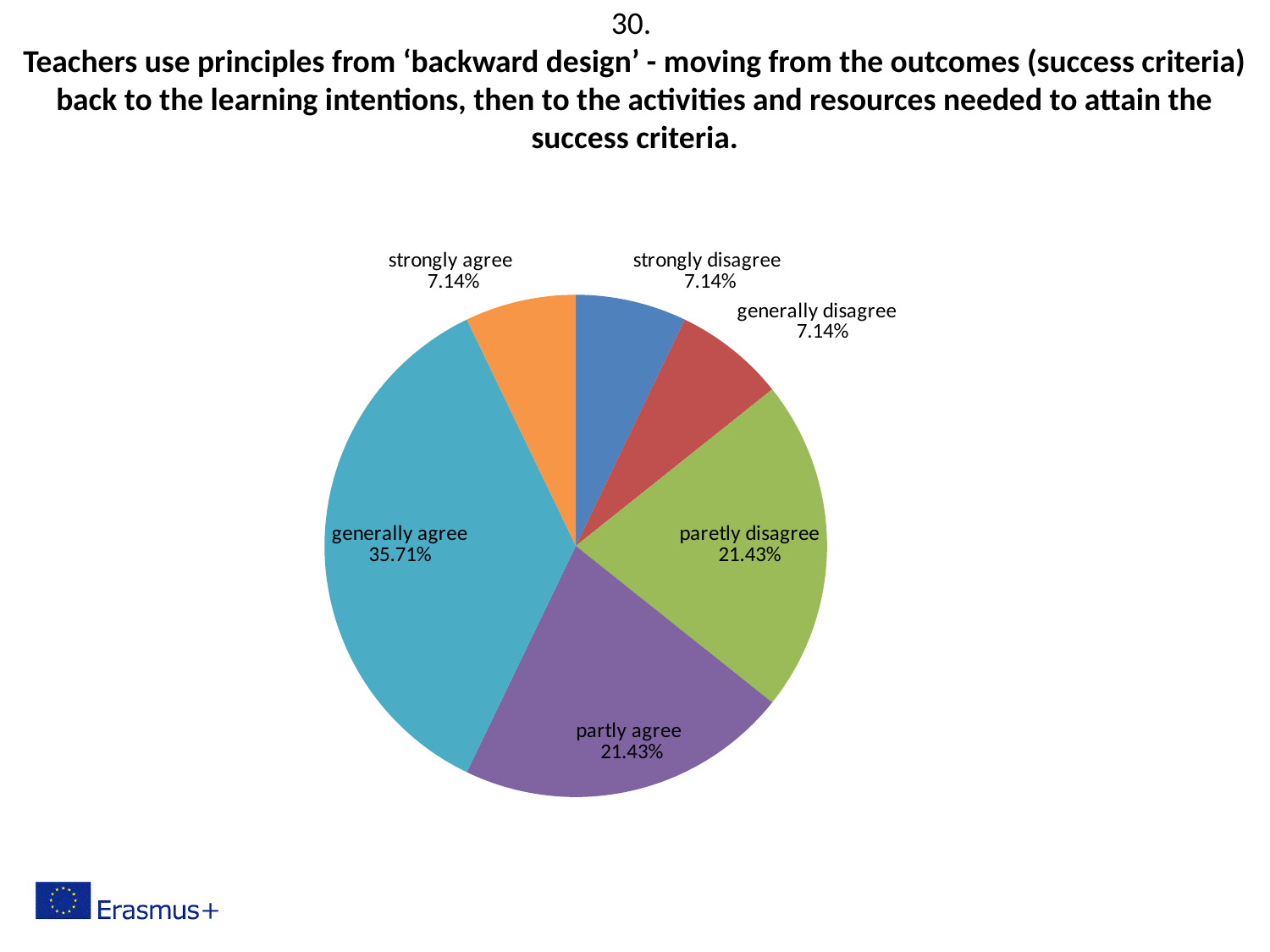
What percentage of respondents chose 'generally disagree'? 7.14% What is the combined percentage of 'strongly disagree', 'generally disagree' and 'paretly disagree'? 35.71% What is the difference in percentage points between 'generally agree' and 'partly agree'? 14.28 How many slices does the pie chart have? 6 Which is larger, the share for 'generally agree' or the share for 'paretly disagree'? generally agree Which response category has the largest share of the pie? generally agree What percentage of respondents chose 'strongly disagree'? 7.14% What kind of chart is shown on the slide? pie chart What percentage of respondents chose 'partly agree'? 21.43% What percentage of respondents chose 'generally agree'? 35.71% What colour is the 'generally agree' slice? teal/light blue What is the combined percentage of 'strongly agree' and 'generally agree'? 42.85%